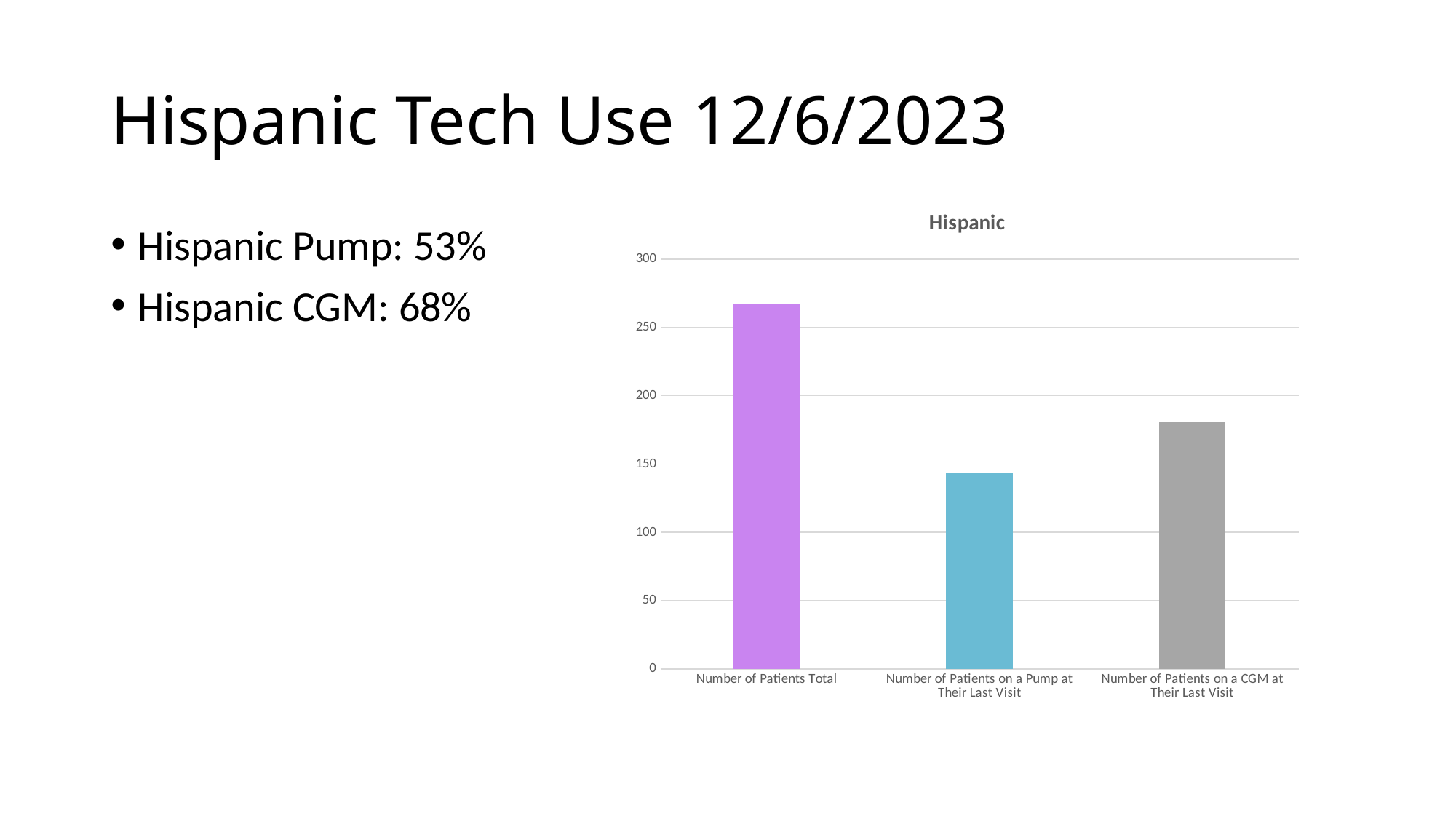
Which category has the highest bar? Number of Patients Total Which category has the lowest bar? Number of Patients on a Pump at Their Last Visit Is the value for Number of Patients Total greater or less than 300? less Which is larger: the number of patients on a CGM at their last visit or the number of patients on a pump at their last visit? Number of Patients on a CGM at Their Last Visit Is the value for Number of Patients Total greater or less than 250? greater Is the value for Number of Patients on a CGM at Their Last Visit greater or less than 200? less What colour is the bar for Number of Patients Total? purple What is the title of the chart? Hispanic How many bars (categories) does the chart show? 3 What kind of chart is shown on the slide? bar chart